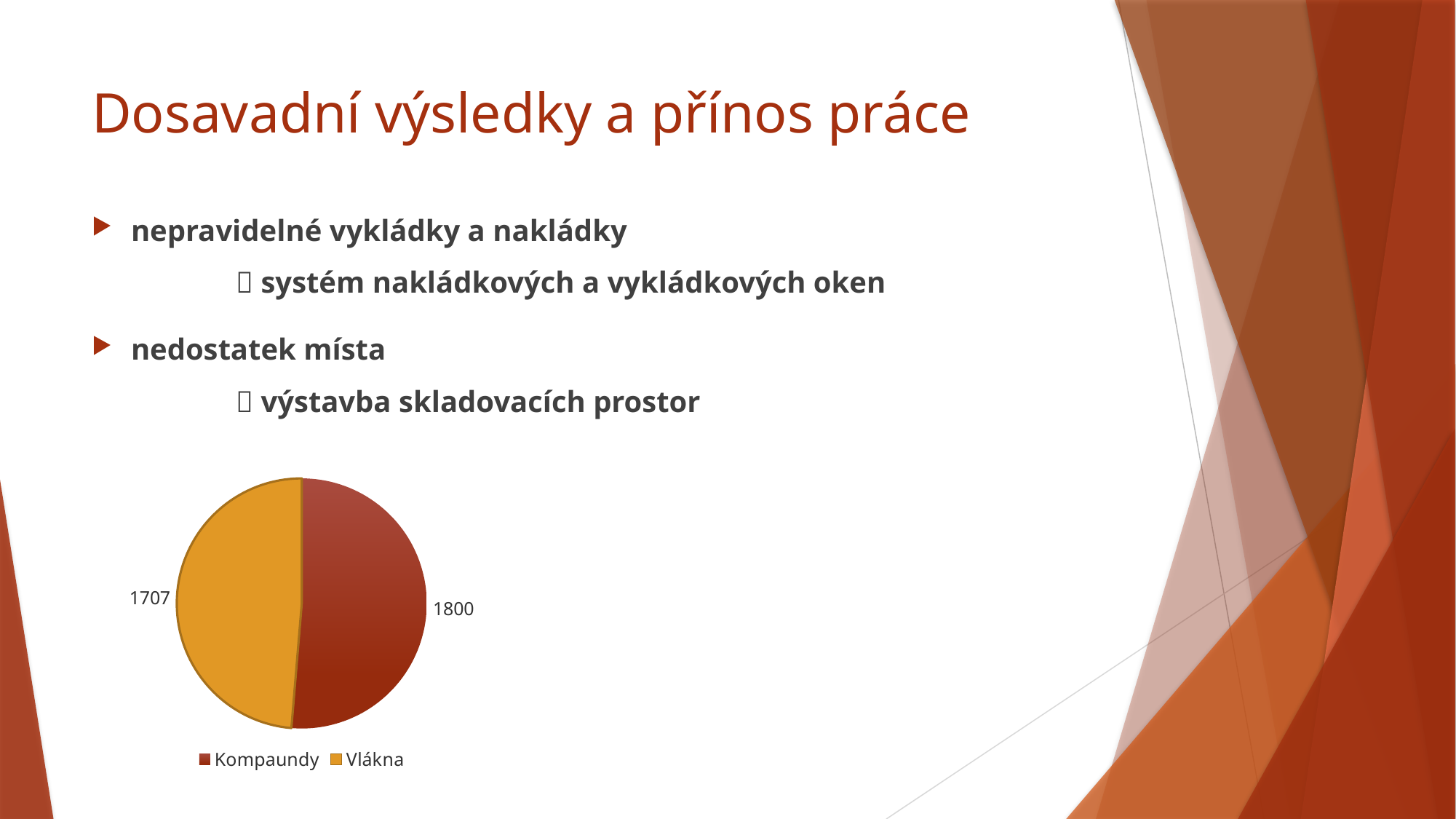
Which slice of the pie chart has the smaller value? Vlákna What is the difference between the values for Kompaundy and Vlákna? 93 What type of chart is shown on the slide? pie chart What is the value for Kompaundy in the pie chart? 1800 Is the value for Kompaundy larger or smaller than the value for Vlákna? larger How many entries does the legend of the pie chart list? 2 What colour is the Vlákna slice in the pie chart? orange Which slice of the pie chart has the larger value? Kompaundy What is the value for Vlákna in the pie chart? 1707 Which legend entry is shown in dark red in the pie chart? Kompaundy What is the total of the two values shown in the pie chart? 3507 How many slices does the pie chart have? 2